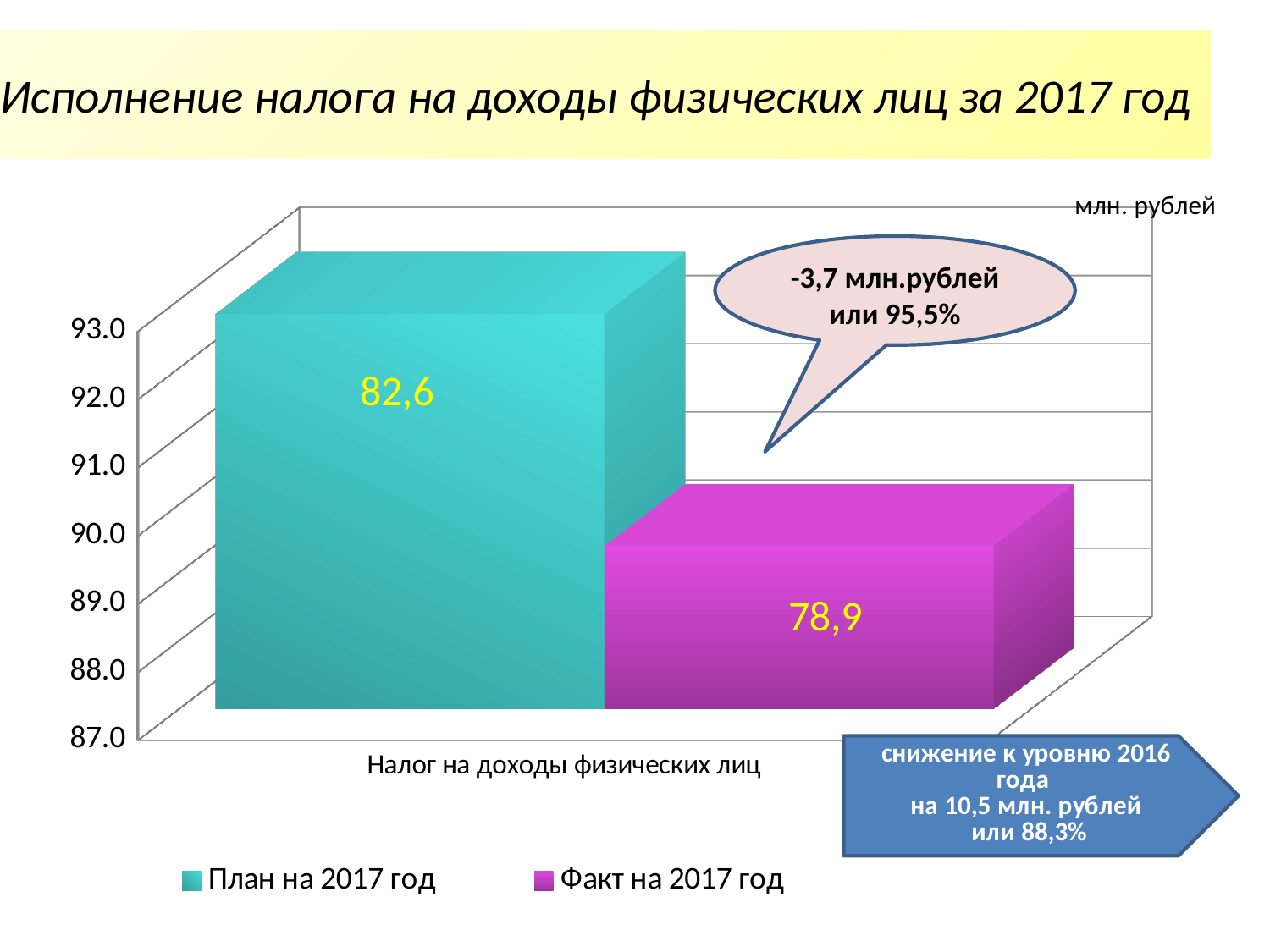
How many series does the legend list? 2 Which series has the highest value? План на 2017 год What unit is indicated in the top right corner of the chart? млн. рублей What kind of chart is shown on the slide? Bar chart How many categories are shown on the x axis? 1 What is the category label on the x axis? Налог на доходы физических лиц Which series has the higher value, План на 2017 год or Факт на 2017 год? План на 2017 год What is the value for Факт на 2017 год? 78,9 What is the difference between the План на 2017 год value and the Факт на 2017 год value? 3,7 What is the title of the slide? Исполнение налога на доходы физических лиц за 2017 год What is the value for План на 2017 год? 82,6 Which series has the lowest value? Факт на 2017 год